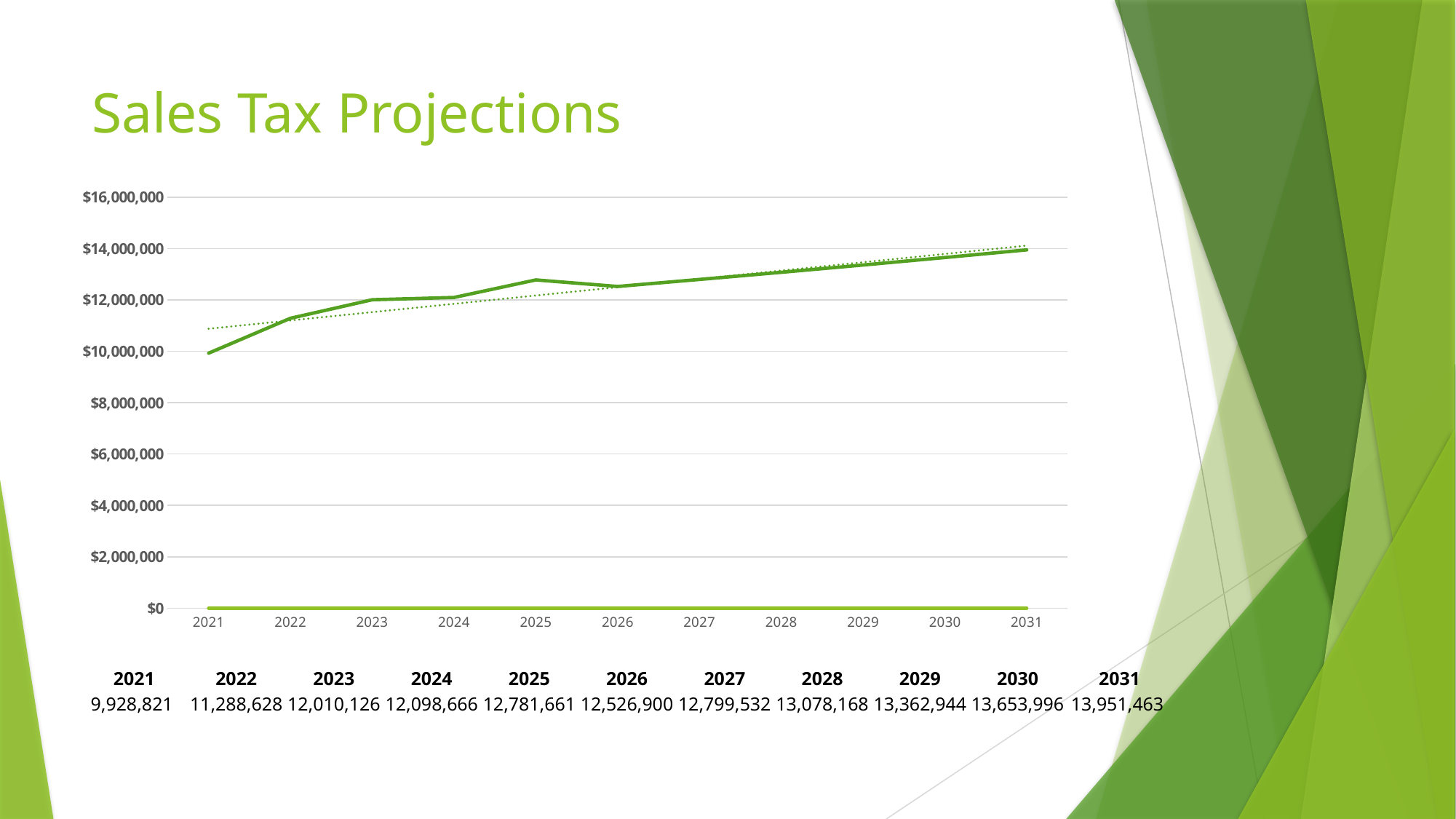
Is the value for 2021 greater or less than $10,000,000? less How many years are plotted on the x axis? 11 Which year has the highest sales tax projection? 2031 What is the sales tax projection value for 2021? 9,928,821 Which year has the larger sales tax projection, 2025 or 2026? 2025 Do the sales tax projections generally rise or fall from 2021 to 2031? Rise What is the difference between the 2025 and 2026 sales tax projections? 254,761 What is the difference between the 2031 and 2021 sales tax projections? 4,022,642 What is the sales tax projection value for 2031? 13,951,463 What is the sales tax projection value for 2026? 12,526,900 What type of chart is shown on the slide? Line chart Which year has the lowest sales tax projection? 2021